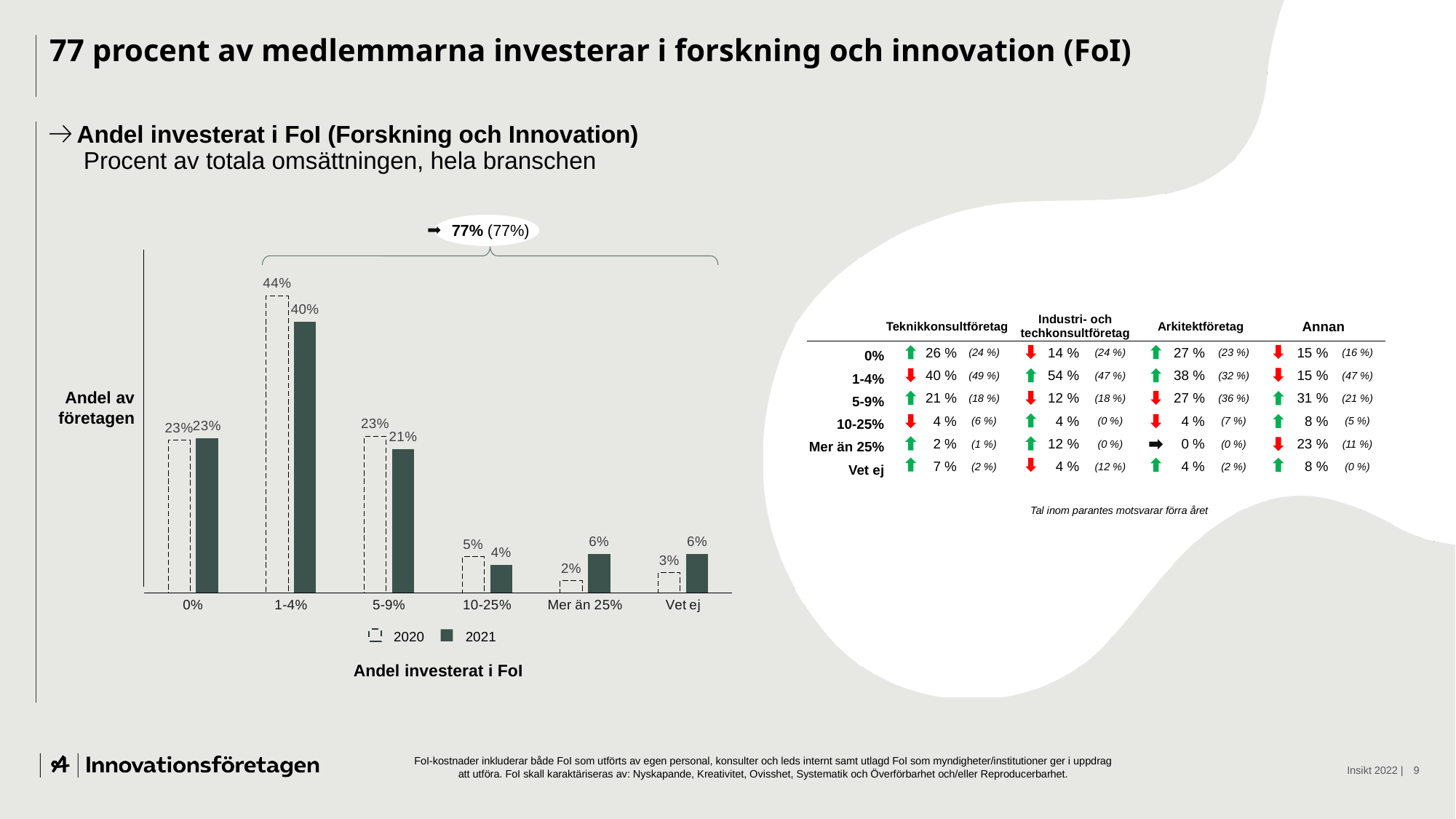
Which is larger for the 5-9% category, the 2020 value or the 2021 value? 2020 How many series does the legend of the bar chart list? 2 What is the 2021 value for the 1-4% category? 40% How many categories are shown on the x axis of the bar chart? 6 What percentage is shown in the callout above the bracket spanning the 1-4% to 'Vet ej' categories? 77% Which category has the highest 2021 value? 1-4% What is the 2021 value for the 'Mer än 25%' category? 6% What is the 2020 value for the 'Vet ej' category? 3% What is the difference between the 2020 and 2021 values for the 1-4% category? 4% Which category has the lowest 2020 value? Mer än 25% What kind of chart is shown on the slide? bar chart What is the 2020 value for the 1-4% category? 44%